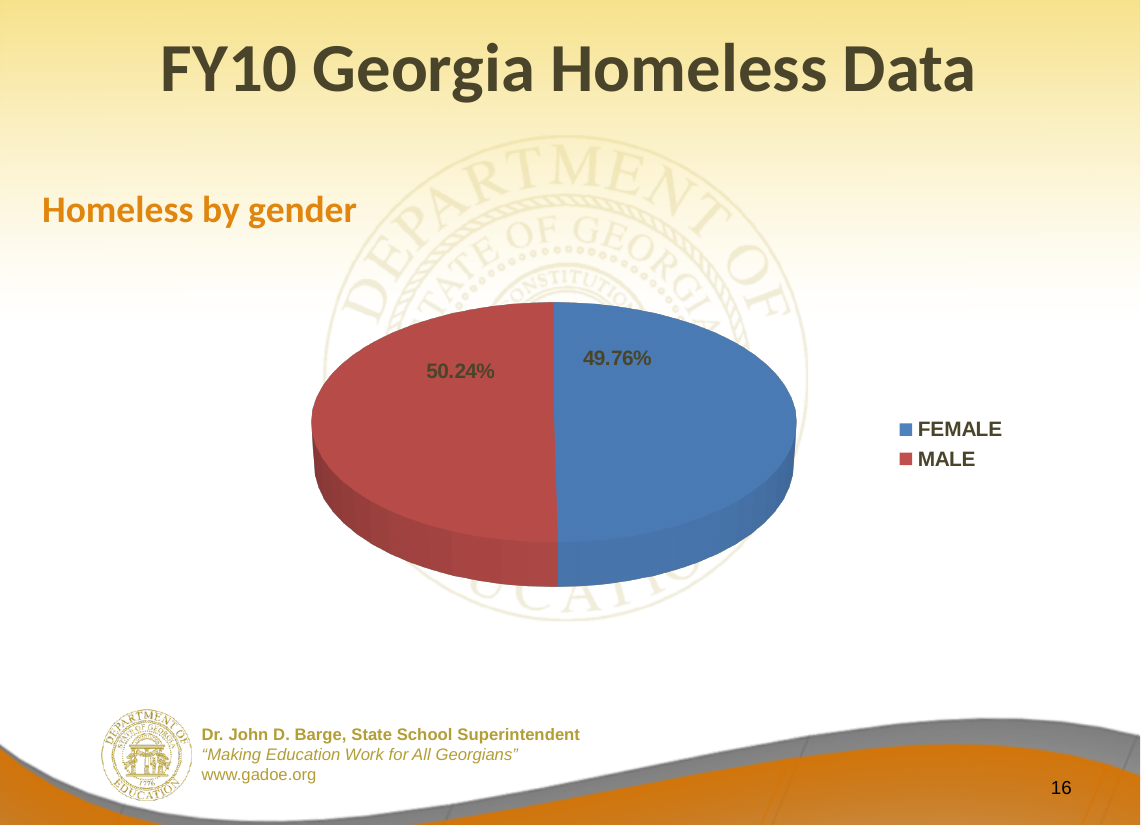
What type of chart is shown on the slide? Pie chart Is the MALE share larger or smaller than the FEMALE share? Larger How many entries does the legend list? 2 Which gender has the larger share in the pie chart? MALE What is the difference in percentage points between the MALE and FEMALE shares? 0.48 percentage points How many categories does the pie chart show? 2 What is the subtitle describing the pie chart? Homeless by gender What percentage of the homeless population is FEMALE according to the pie chart? 49.76% Which gender has the smaller share in the pie chart? FEMALE What percentage of the homeless population is MALE according to the pie chart? 50.24% What colour represents FEMALE in the pie chart? Blue Is the FEMALE share greater or less than 50%? less